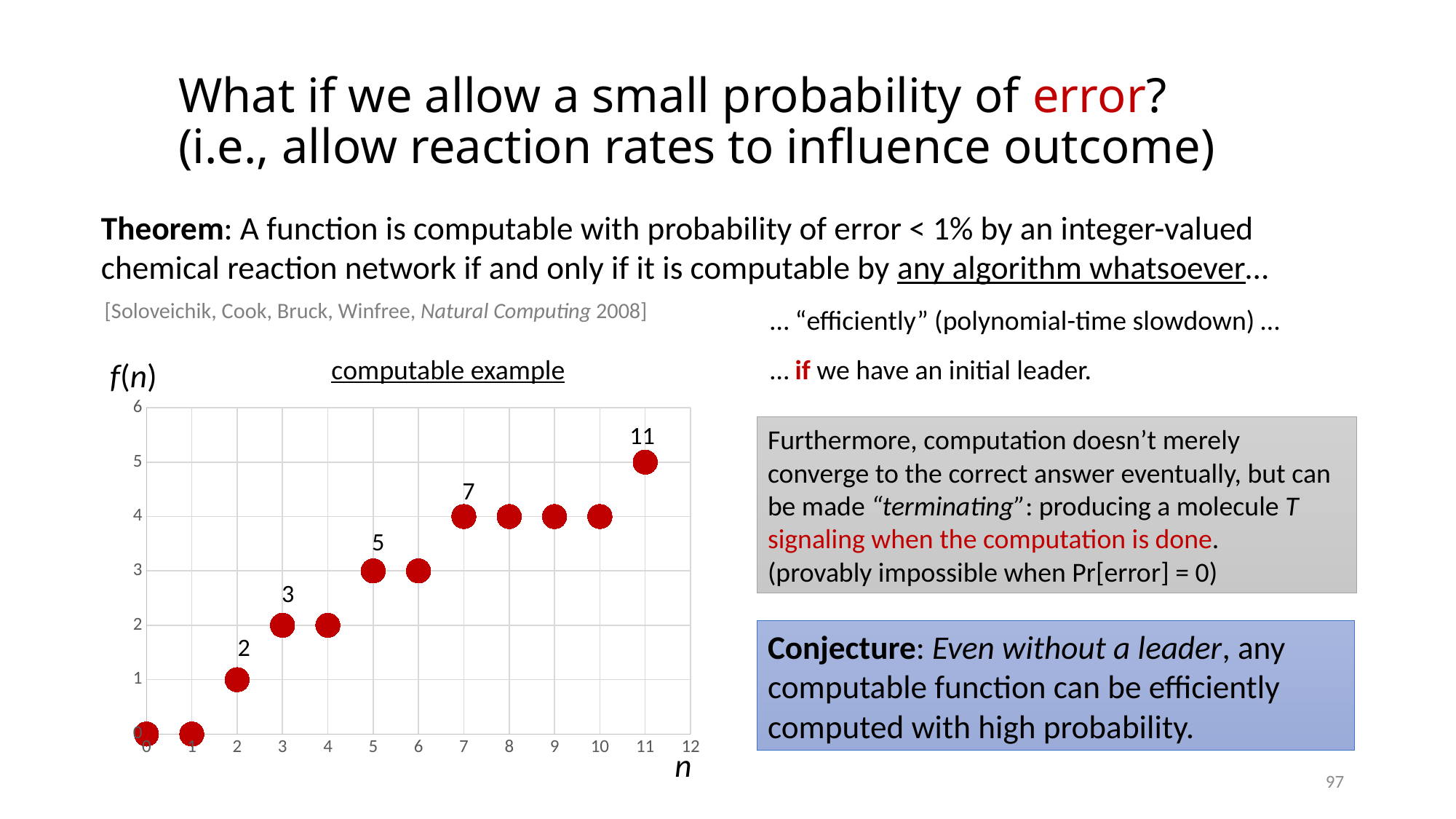
In the "computable example" chart, what is the value of f(n) at n = 11? 5 In the "computable example" chart, is the value of f(n) at n = 11 greater or less than 4? greater How many data points are plotted in the "computable example" chart? 12 In the "computable example" chart, what is the difference between f(n) at n = 11 and f(n) at n = 7? 1 What kind of chart is the "computable example" chart? scatter plot In the "computable example" chart, what is the value of f(n) at n = 7? 4 What is the title of the chart on the slide? computable example In the "computable example" chart, what is the lowest plotted value of f(n)? 0 In the "computable example" chart, which is larger: f(n) at n = 5 or f(n) at n = 3? f(n) at n = 5 In the "computable example" chart, at which value of n is f(n) highest? 11 In the "computable example" chart, what is the value of f(n) at n = 2? 1 In the "computable example" chart, do the values of f(n) generally rise or fall as n increases? rise